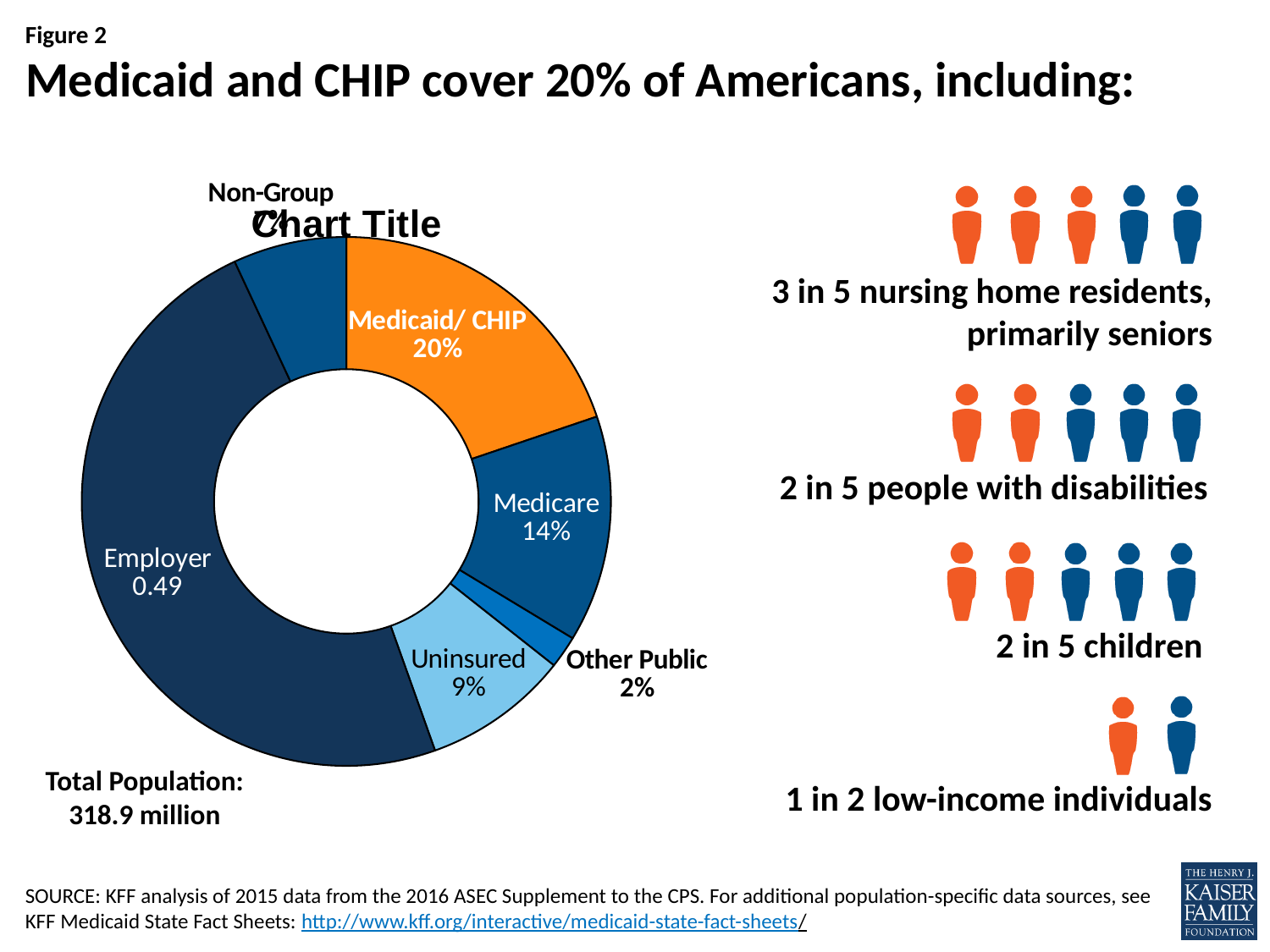
What value is shown for Uninsured in the chart? 9% Which category has the largest slice in the chart? Employer What kind of chart is shown on the left of the slide? Doughnut (pie) chart Which is larger in the chart, the Medicare share or the Uninsured share? Medicare How many categories (slices) does the chart have? 6 What value is printed on the Employer slice of the chart? 0.49 Which labelled category has the smallest slice in the chart? Other Public What value is shown for Other Public in the chart? 2% What share of the population is covered by Medicaid/CHIP in the chart? 20% What total population is stated below the chart? 318.9 million How many percentage points larger is the Medicaid/CHIP share than the Medicare share? 6 percentage points What value is shown for Medicare in the chart? 14%